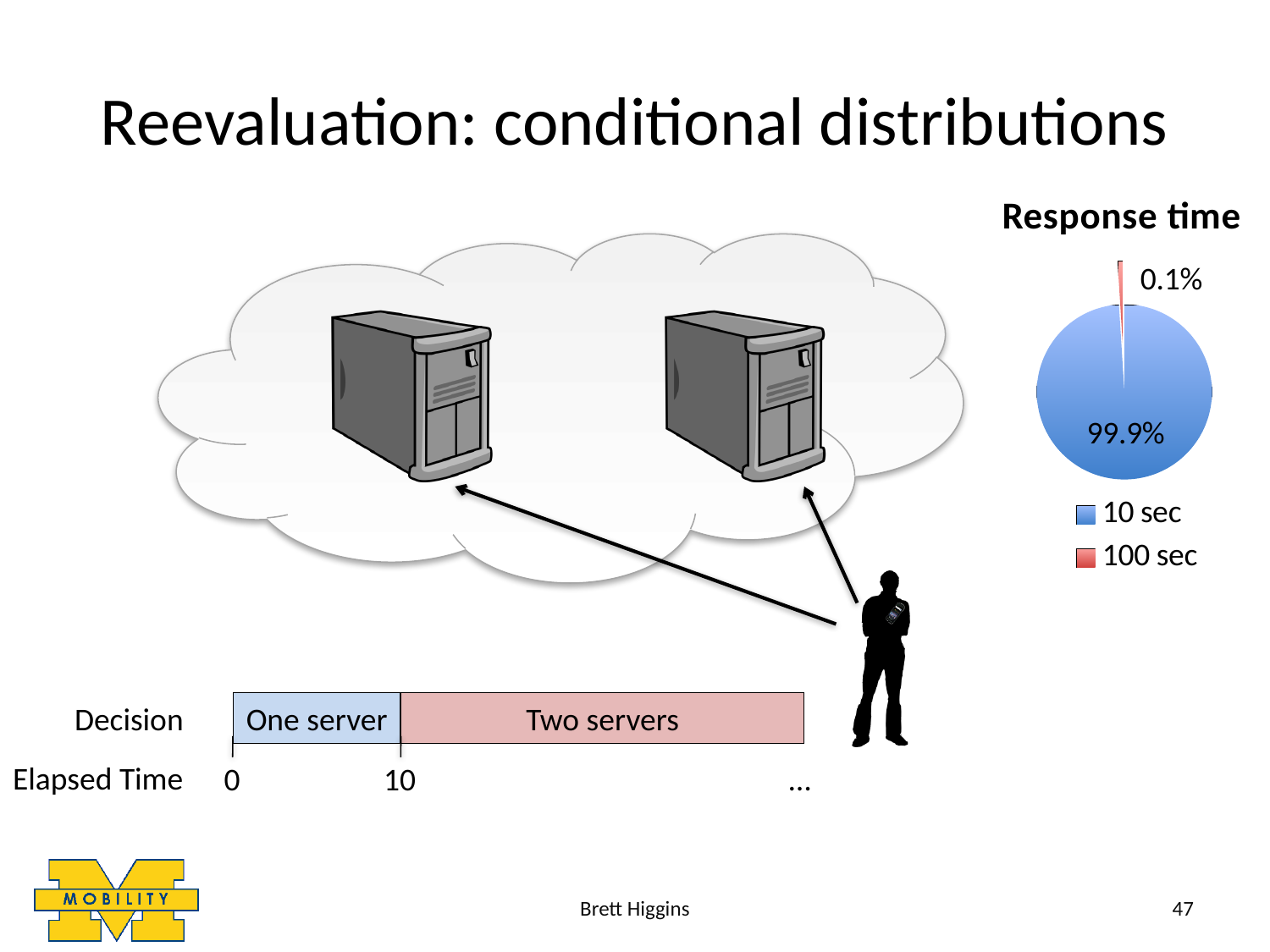
In the "Response time" pie chart, which category has the largest slice? 10 sec In the "Response time" pie chart, which slice is larger: 10 sec or 100 sec? 10 sec In the "Response time" pie chart, what share does the 10 sec slice have? 99.9% What kind of chart is the "Response time" chart? pie chart In the "Response time" pie chart, what is the difference between the 10 sec share and the 100 sec share? 99.8% In the "Response time" pie chart, which category has the smallest slice? 100 sec What is the title of the pie chart on the slide? Response time In the "Response time" pie chart, what colour is the 100 sec slice? red In the "Response time" pie chart, what share does the 100 sec slice have? 0.1% How many entries does the legend of the "Response time" pie chart list? 2 How many slices does the "Response time" pie chart have? 2